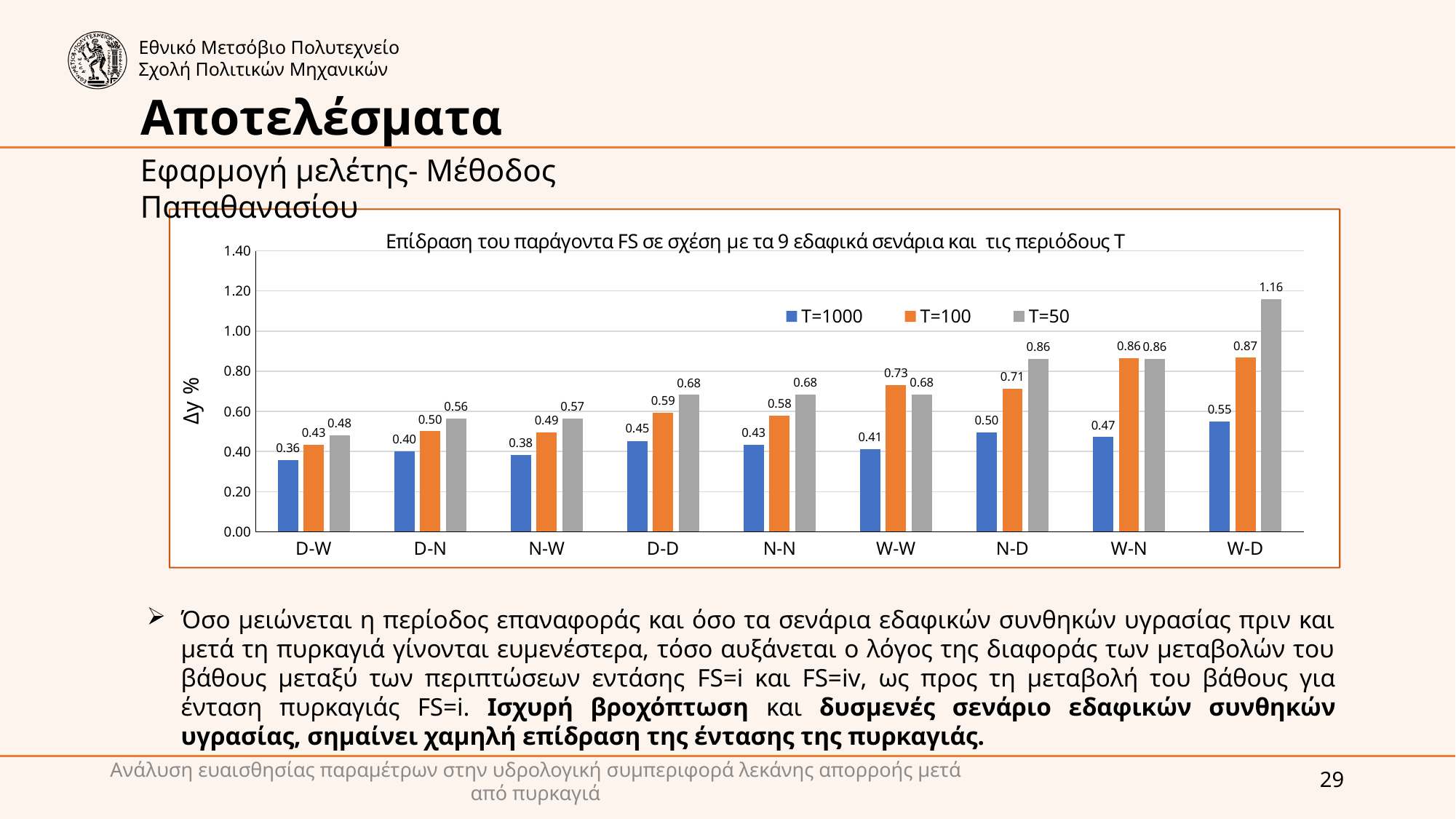
How many series does the legend list? 3 What kind of chart is shown? bar chart What is the value for T=50 at W-D? 1.16 Which category has the lowest T=50 value? D-W What is the value for T=100 at W-W? 0.73 What is the label of the y axis? Δy % What is the difference between the T=50 and T=1000 values at W-D? 0.61 How many categories are shown on the x axis? 9 What is the value for T=1000 at D-W? 0.36 Is the value for T=50 at W-D greater or less than 1.00? greater Which is larger at W-W: the T=100 value or the T=50 value? T=100 Which category has the highest T=1000 value? W-D